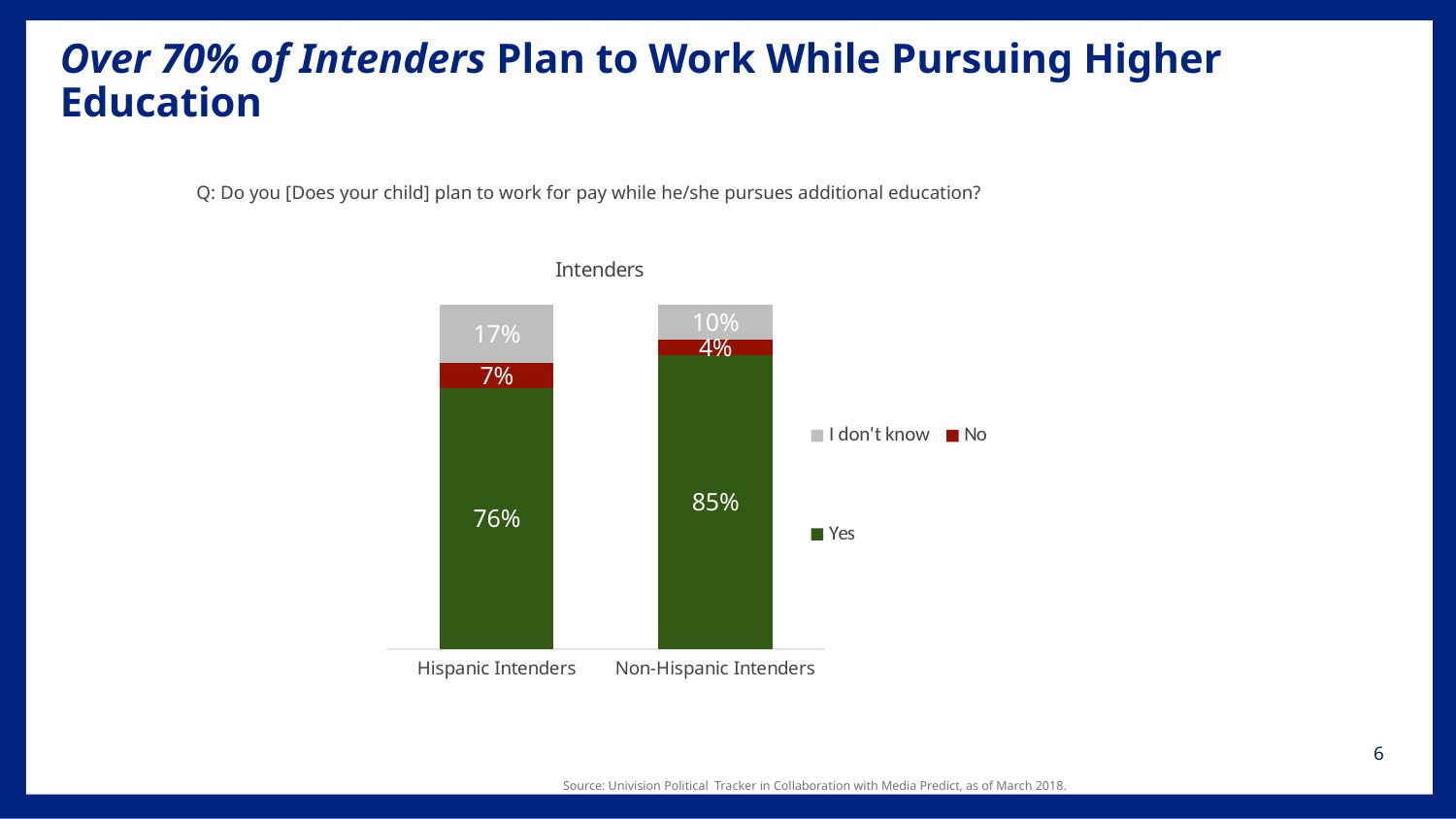
What is the difference between the "Yes" percentages for Non-Hispanic Intenders and Hispanic Intenders? 9% What is the total of the stacked bar for Hispanic Intenders? 100% Which group has the higher "Yes" share, Hispanic Intenders or Non-Hispanic Intenders? Non-Hispanic Intenders What type of chart is shown on the slide? Stacked bar chart What percentage of Non-Hispanic Intenders answered "Yes"? 85% What percentage of Non-Hispanic Intenders answered "I don't know"? 10% What is the difference between the "I don't know" percentages for Hispanic Intenders and Non-Hispanic Intenders? 7% How many series does the legend list? 3 What percentage of Hispanic Intenders answered "No"? 7% How many categories are shown on the x axis? 2 What is the total of the stacked bar for Non-Hispanic Intenders? 99% What percentage of Hispanic Intenders answered "Yes"? 76%